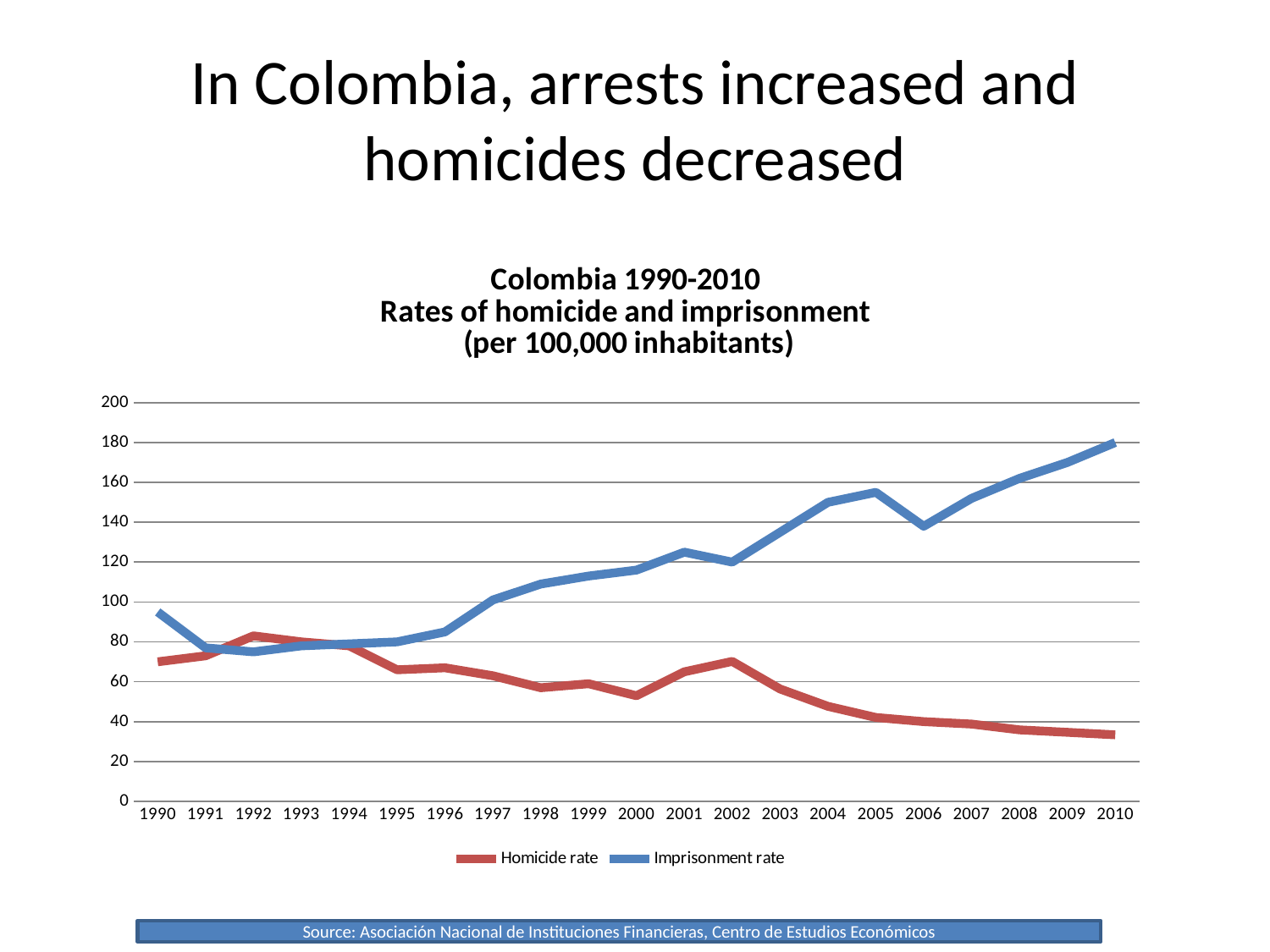
In which year is the imprisonment rate highest? 2010 In 2010, which is larger, the homicide rate or the imprisonment rate? Imprisonment rate In which year is the homicide rate lowest? 2010 How many years are plotted along the x axis? 21 What colour is the line for the homicide rate? red What kind of chart is shown on the slide? line chart Is the imprisonment rate in 2010 greater or less than 160? greater Is the homicide rate in 2010 greater or less than 40? less Does the homicide rate rise or fall from 2002 to 2010? fall Does the imprisonment rate rise or fall from 1995 to 2005? rise How many series does the legend list? 2 Is the imprisonment rate in 2005 greater or less than 140? greater